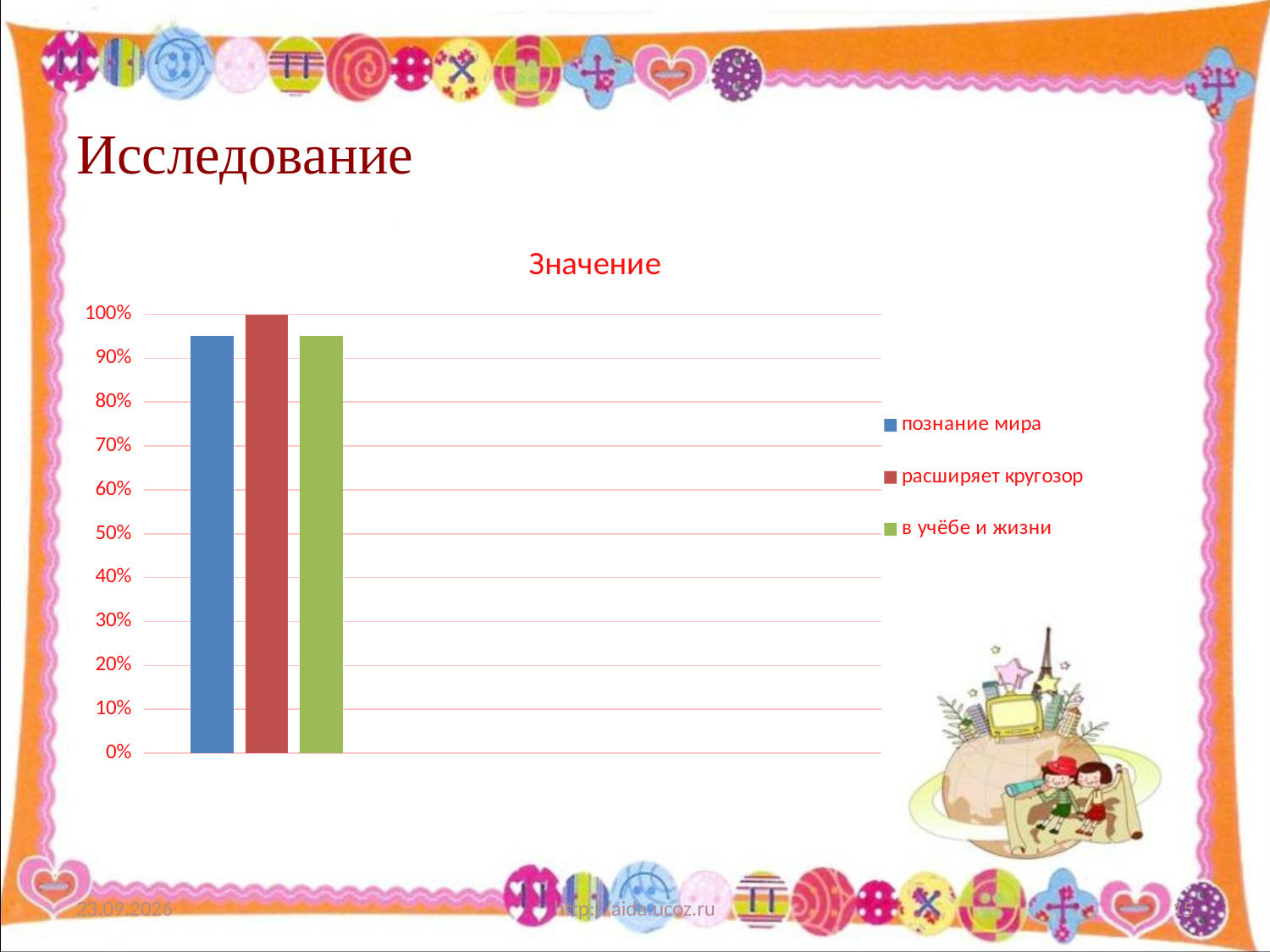
How many bars are plotted in the chart? 3 How many series does the legend list? 3 Which is larger, the value for расширяет кругозор or the value for в учёбе и жизни? расширяет кругозор What is the title of the chart? Значение Which is larger, the value for познание мира or the value for расширяет кругозор? расширяет кругозор Is the value for познание мира greater or less than 90%? greater What is the value for расширяет кругозор? 100% What kind of chart is shown on the slide? bar chart Which series has the highest value? расширяет кругозор Is the value for в учёбе и жизни greater or less than 90%? greater Is the value for познание мира greater or less than 100%? less Which colour represents the series в учёбе и жизни in the legend? green